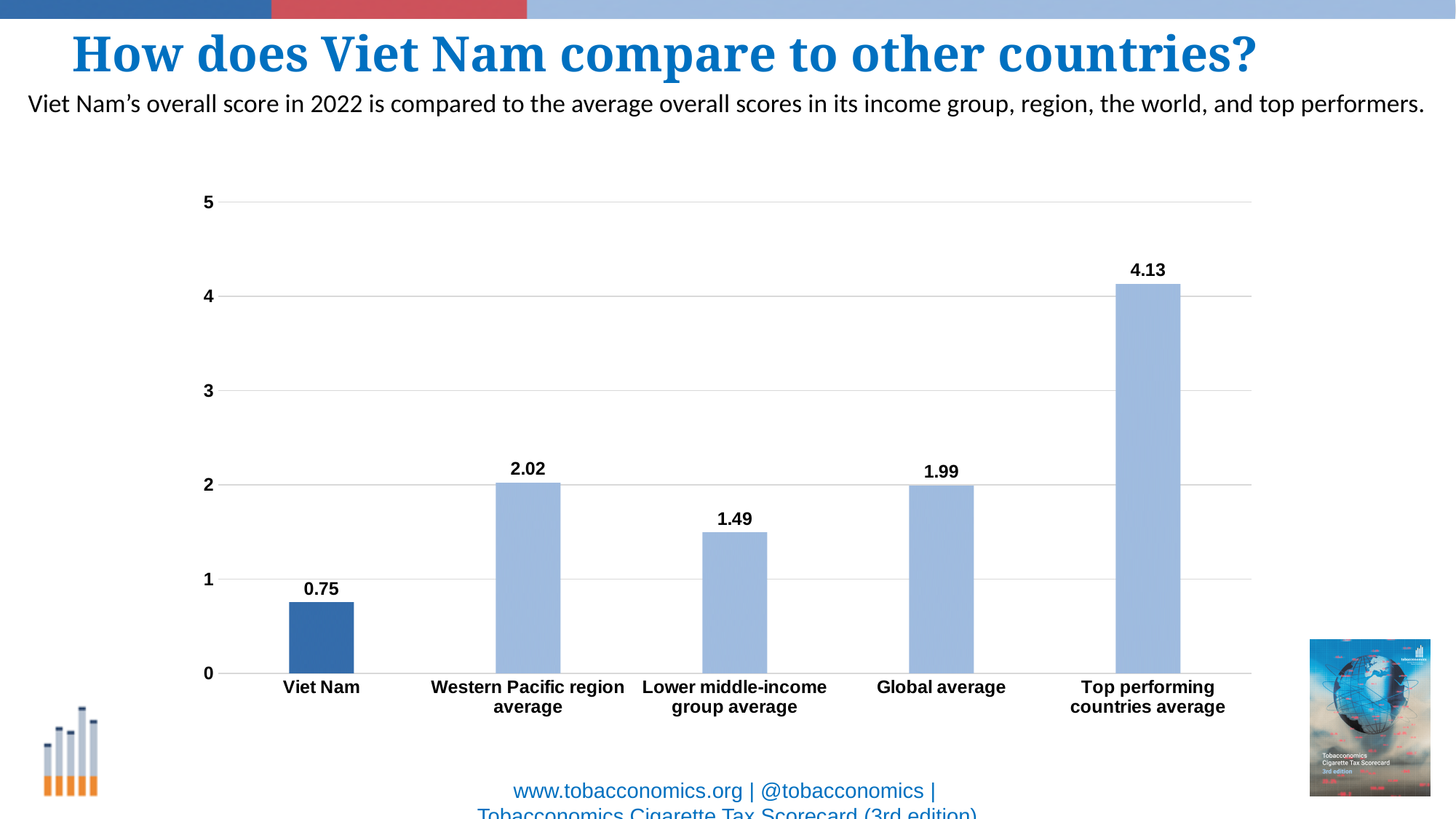
What is the difference between the Global average and the Lower middle-income group average? 0.50 What kind of chart is shown on the slide? Bar chart Which is larger, the Western Pacific region average or the Global average? Western Pacific region average What is the value shown for the Top performing countries average? 4.13 What is the value shown for the Western Pacific region average? 2.02 What is the overall score shown for Viet Nam? 0.75 Which category has the highest value? Top performing countries average Which category has the lowest value? Viet Nam How many categories are shown on the chart? 5 What is the difference between the Top performing countries average and Viet Nam's score? 3.38 Is the value for the Lower middle-income group average greater or less than 2? less What is the value shown for the Lower middle-income group average? 1.49